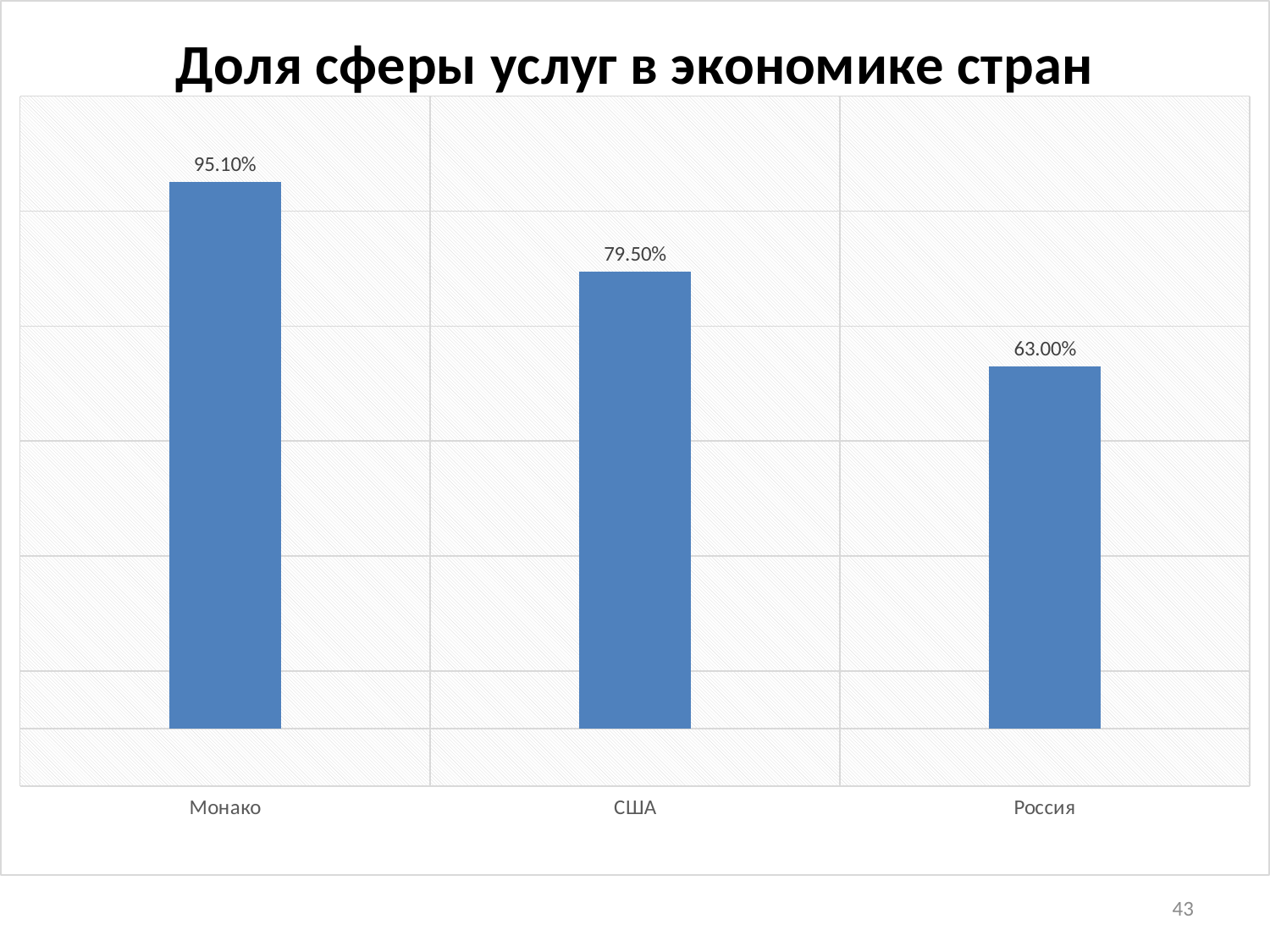
What is the value for Монако? 95.10% What is the difference between the values for Монако and США? 15.60% What kind of chart is shown on the slide? Bar chart What is the title of the chart? Доля сферы услуг в экономике стран Which country has the lowest share of the service sector? Россия What is the value for США? 79.50% What is the value for Россия? 63.00% What is the difference between the values for США and Россия? 16.50% How many countries are shown in the chart? 3 Which country has the highest share of the service sector? Монако Which is larger, the value for США or the value for Россия? США What is the difference between the values for Монако and Россия? 32.10%